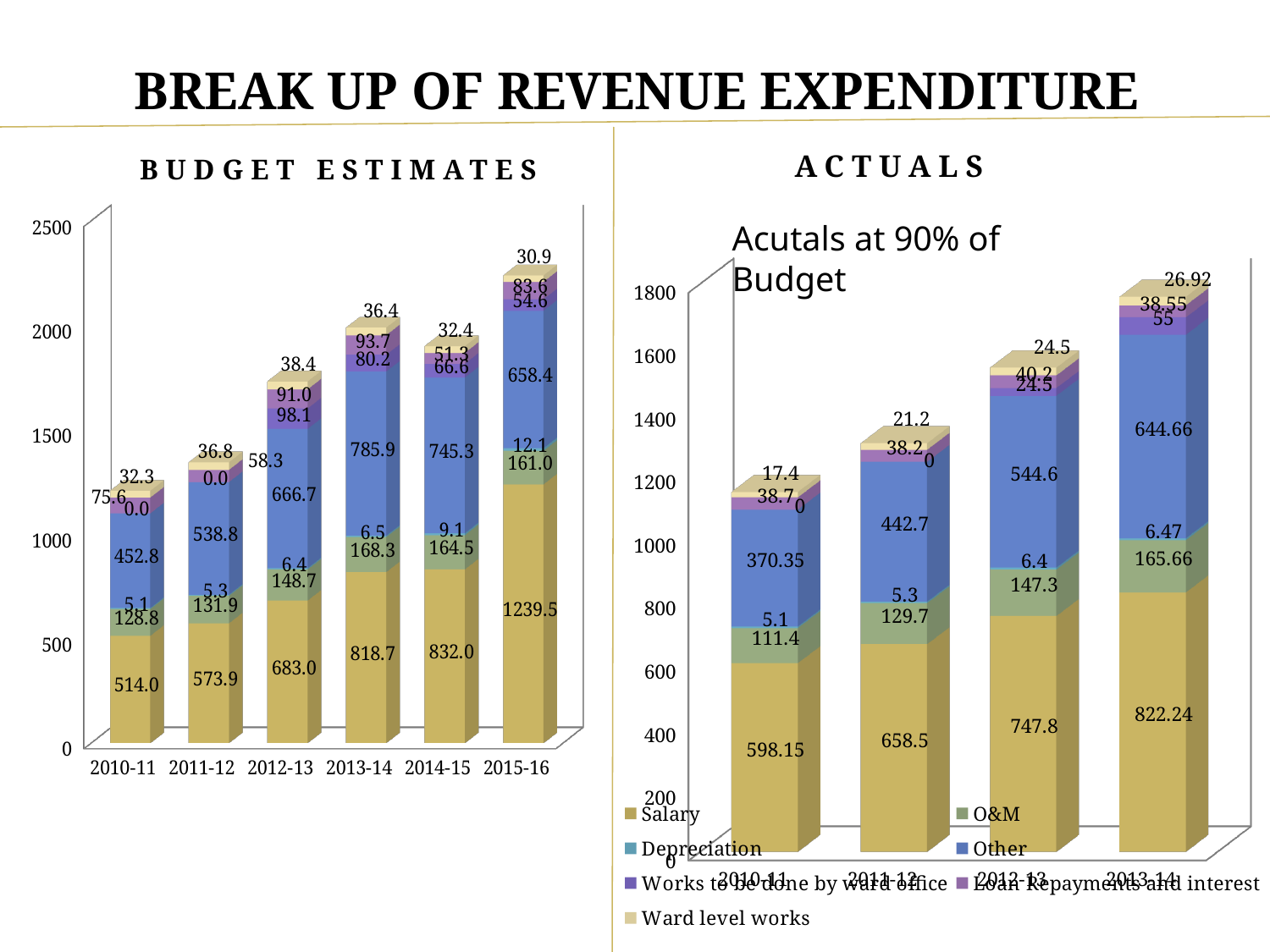
In the BUDGET ESTIMATES chart, which year has the larger Other value, 2013-14 or 2014-15? 2013-14 In the ACTUALS chart, what is the Other value for 2012-13? 544.6 In the BUDGET ESTIMATES chart, what is the difference between the Salary values for 2015-16 and 2014-15? 407.5 How many years are shown on the x axis of the ACTUALS chart? 4 In the BUDGET ESTIMATES chart, which year has the highest Salary value? 2015-16 In the ACTUALS chart, what is the difference between the Salary values for 2013-14 and 2010-11? 224.09 In the ACTUALS chart, what is the Salary value for 2013-14? 822.24 In the ACTUALS chart, does the Salary value rise or fall from 2010-11 to 2013-14? Rises How many years are shown on the x axis of the BUDGET ESTIMATES chart? 6 What kind of chart is the BUDGET ESTIMATES chart? Stacked bar chart How many series does the legend of the ACTUALS chart list? 7 In the BUDGET ESTIMATES chart, what is the Salary value for 2015-16? 1239.5